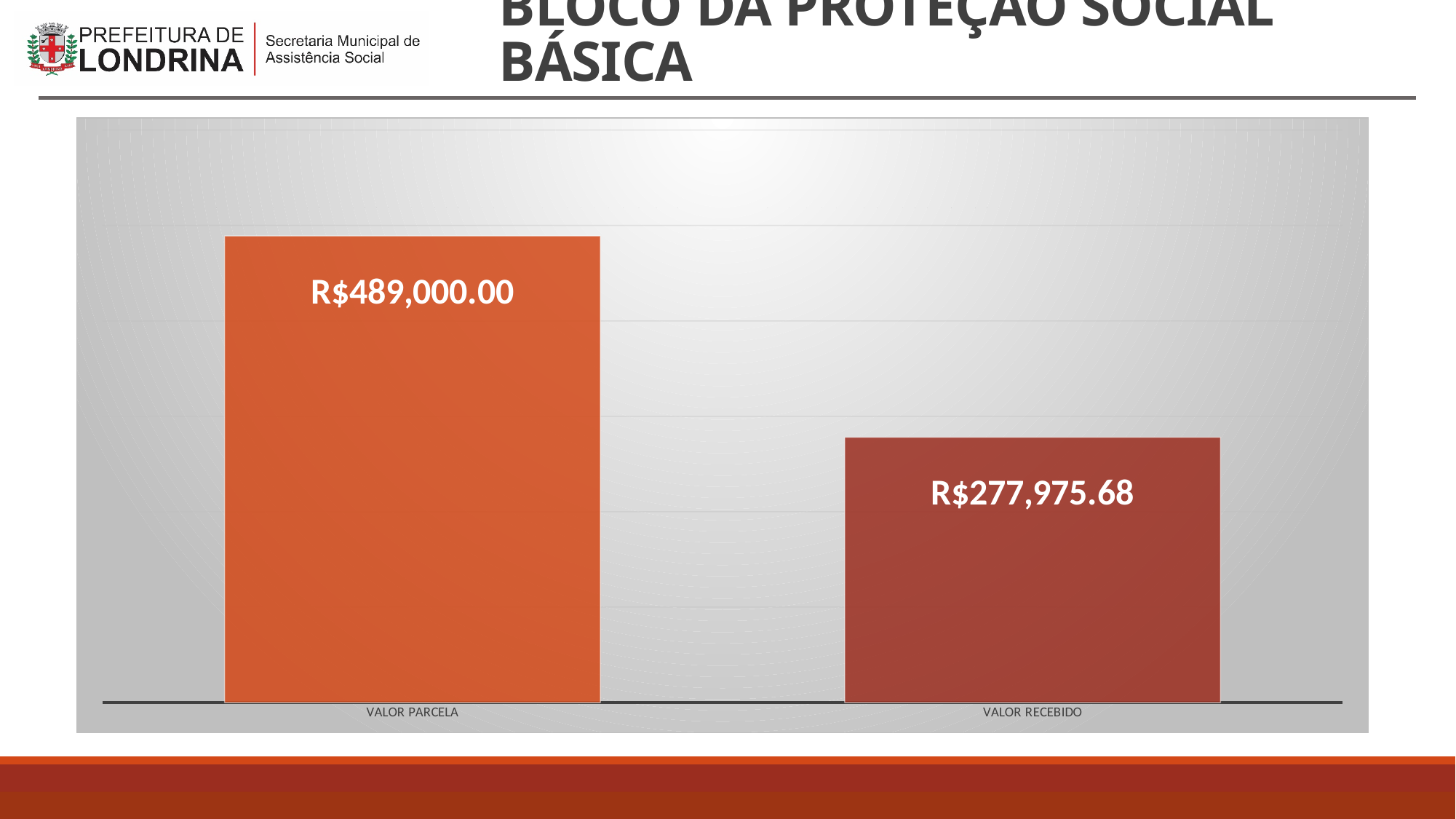
How many categories are shown in the chart? 2 Which category has the lowest value? VALOR RECEBIDO What is the difference between VALOR PARCELA and VALOR RECEBIDO? R$211,024.32 What is the label of the left bar on the x axis? VALOR PARCELA What is the value for VALOR RECEBIDO? R$277,975.68 Which category has the highest value? VALOR PARCELA What is the title of the slide containing the chart? BLOCO DA PROTEÇÃO SOCIAL BÁSICA What is the value for VALOR PARCELA? R$489,000.00 What kind of chart is shown on the slide? Bar chart Do the values rise or fall from VALOR PARCELA to VALOR RECEBIDO? Fall Which is larger, VALOR PARCELA or VALOR RECEBIDO? VALOR PARCELA